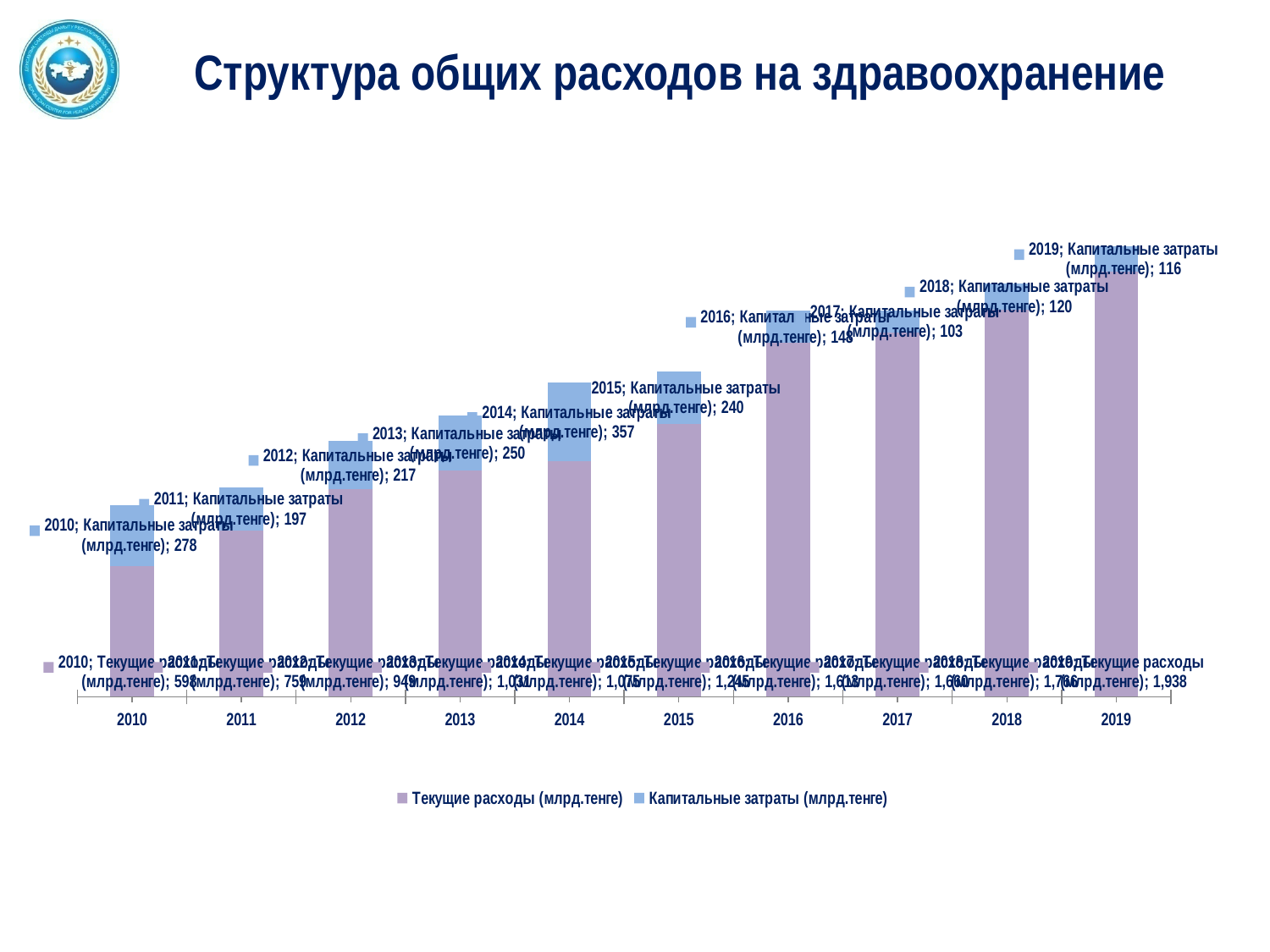
What is the value of Капитальные затраты (млрд.тенге) for 2019? 116 What kind of chart is shown on the slide? bar chart How many years are shown on the x axis? 10 What is the value of Капитальные затраты (млрд.тенге) for 2014? 357 What is the total of the stacked bar for 2019? 2,054 What is the value of Текущие расходы (млрд.тенге) for 2019? 1,938 Do the values of Текущие расходы (млрд.тенге) rise or fall from 2010 to 2019? rise Which year has the larger value of Капитальные затраты (млрд.тенге), 2010 or 2011? 2010 How many series does the legend list? 2 Which year has the lowest value of Капитальные затраты (млрд.тенге)? 2017 Which year has the highest value of Капитальные затраты (млрд.тенге)? 2014 What is the difference between Текущие расходы (млрд.тенге) in 2019 and in 2010? 1,340